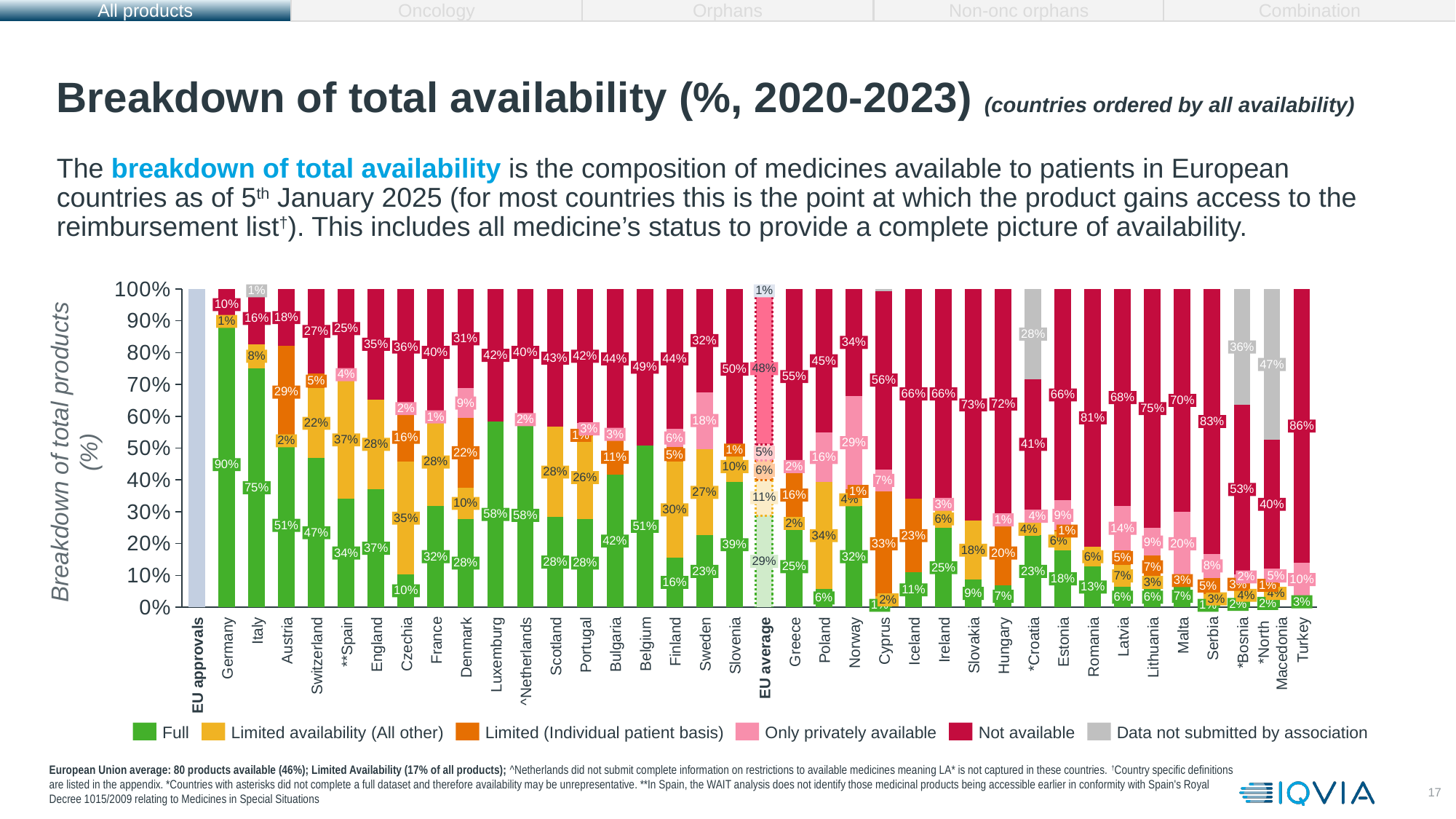
What is the Data not submitted by association value for North Macedonia? 47% What kind of chart is shown on the slide? Stacked bar chart What is the Full availability value for Germany? 90% Which country has the highest Full availability value? Germany Which is larger, the Full availability value for Luxembourg or for Belgium? Luxembourg Which country has the highest Not available value? Turkey How many series does the legend list? 6 Which legend entry is shown in grey? Data not submitted by association What is the Not available value for Turkey? 86% What is the Only privately available value for Norway? 29% What is the Limited availability (All other) value for Poland? 34% What is the difference between the Full availability values of Germany and Italy? 15%